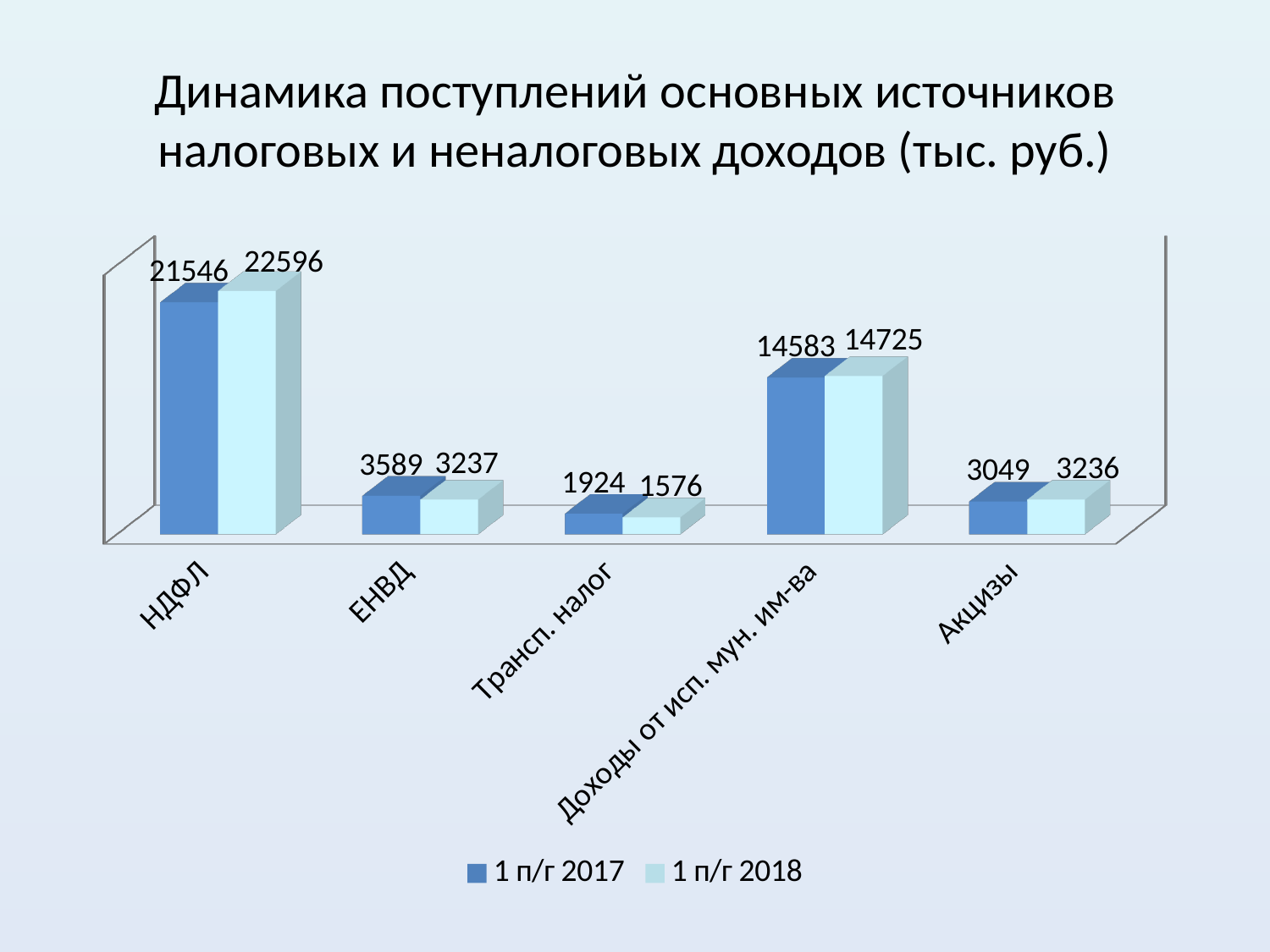
What is the value for НДФЛ in the 1 п/г 2018 series? 22596 Which category has the lowest value in the 1 п/г 2018 series? Трансп. налог What are the two series named in the legend? 1 п/г 2017 and 1 п/г 2018 How many series does the legend list? 2 What kind of chart is shown on the slide? bar chart What is the difference between the 1 п/г 2018 and 1 п/г 2017 values for НДФЛ? 1050 Which category has the highest value in the 1 п/г 2017 series? НДФЛ What is the value for Акцизы in the 1 п/г 2018 series? 3236 Which is larger for Доходы от исп. мун. им-ва: the 1 п/г 2017 value or the 1 п/г 2018 value? 1 п/г 2018 What is the difference between the 1 п/г 2017 and 1 п/г 2018 values for ЕНВД? 352 How many categories are shown on the x axis? 5 What is the value for Трансп. налог in the 1 п/г 2017 series? 1924